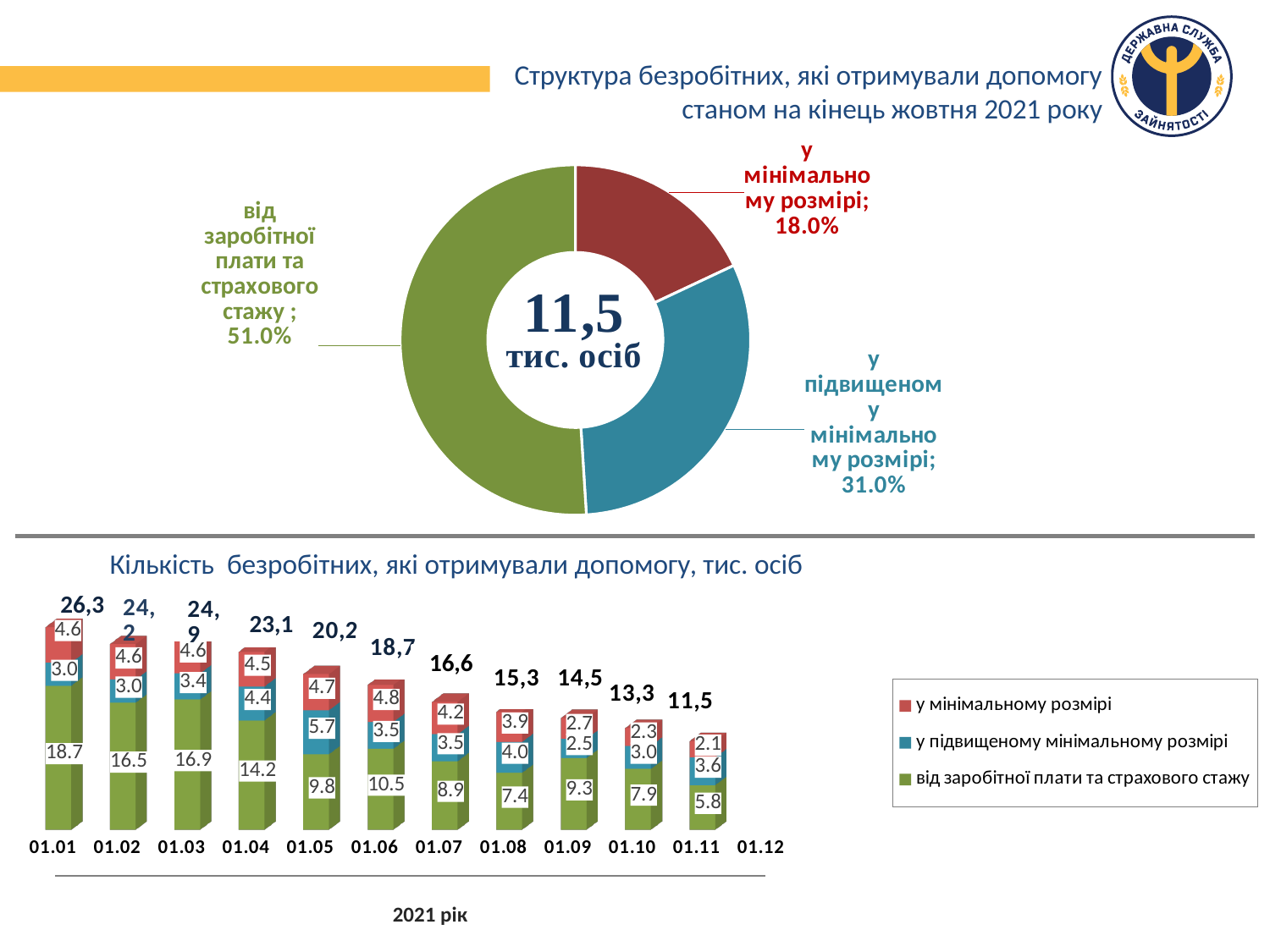
In the bottom bar chart, what is the total for 01.01? 26,3 In the bottom bar chart, which date has the lowest total? 01.11 In the donut chart at the top of the slide, what total number is shown in the centre? 11,5 тис. осіб In the donut chart at the top of the slide, what share of the unemployed received benefits 'у мінімальному розмірі'? 18.0% In the bottom bar chart, what is the value of 'у підвищеному мінімальному розмірі' for 01.11? 3.6 In the bottom bar chart, what is the value of 'від заробітної плати та страхового стажу' for 01.05? 9.8 In the bottom bar chart, how many series does the legend list? 3 In the bottom bar chart, which is larger: the 'у мінімальному розмірі' value for 01.06 or for 01.10? 01.06 In the bottom bar chart, do the totals generally rise or fall from 01.01 to 01.11? fall In the donut chart at the top of the slide, what is the difference in percentage points between the 'у підвищеному мінімальному розмірі' share and the 'у мінімальному розмірі' share? 13.0 What kind of chart is the bottom chart 'Кількість безробітних, які отримували допомогу, тис. осіб'? stacked bar chart In the donut chart at the top of the slide, which category has the largest share? від заробітної плати та страхового стажу